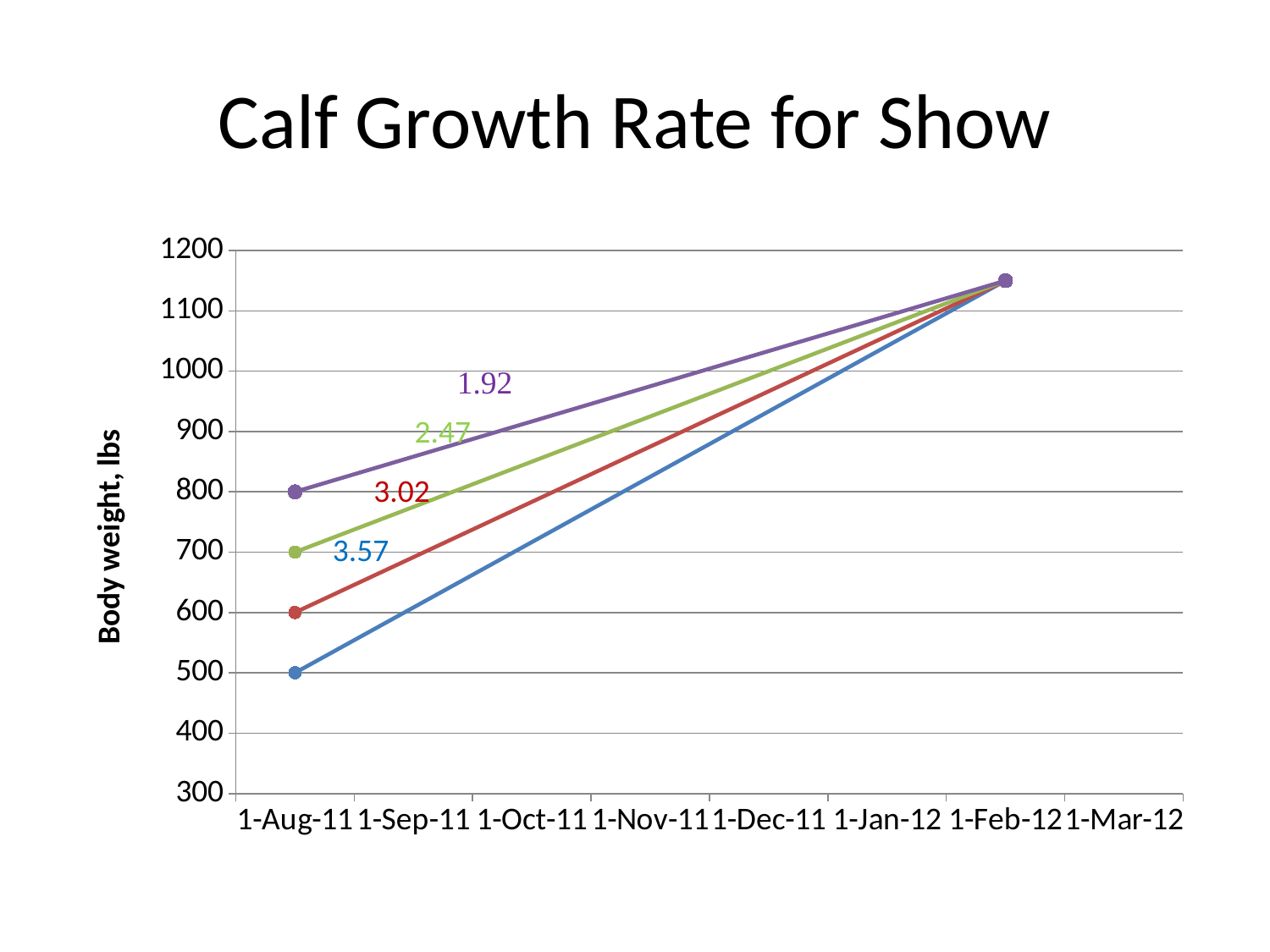
Which line has the lowest body weight on 1-Aug-11? blue Which line has the highest body weight on 1-Aug-11? purple What is the body weight of the red line on 1-Aug-11? 600 What is the title of the y axis? Body weight, lbs What kind of chart is shown on the slide? line chart Do the body weight lines rise or fall from 1-Aug-11 to 1-Feb-12? rise What is the body weight of the blue line on 1-Aug-11? 500 Is the body weight where the lines meet on 1-Feb-12 greater or less than 1100? greater What is the body weight of the green line on 1-Aug-11? 700 How many dates are labelled along the x axis? 8 What is the difference between the purple line and the blue line on 1-Aug-11? 300 What is the body weight of the purple line on 1-Aug-11? 800